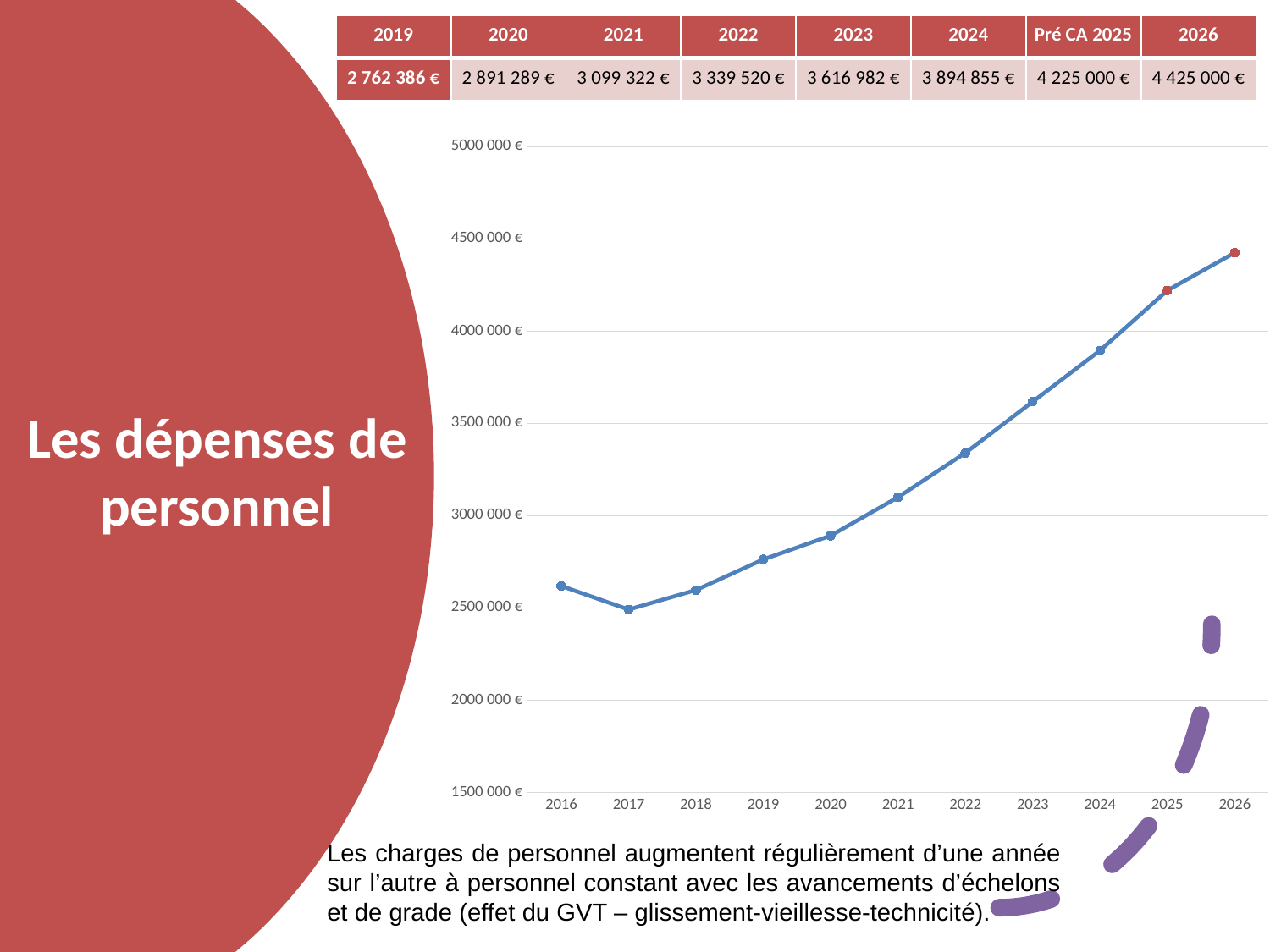
Is the value for 2016 greater or less than 3000 000 €? less Which is larger, the value for 2021 or the value for 2022? 2022 How many years are plotted along the x axis of the chart? 11 Do the values rise or fall from 2017 to 2026? rise Which year has the lowest value on the chart? 2017 What is the personnel expenditure value for 2023? 3 616 982 € What is the personnel expenditure value for 2020? 2 891 289 € Which year has the highest value on the chart? 2026 What is the difference between the 2026 value and the Pré CA 2025 value? 200 000 € Is the value for 2018 greater or less than 2500 000 €? greater What kind of chart is shown on the slide? line chart What colour are the markers for the 2025 and 2026 points on the chart? red